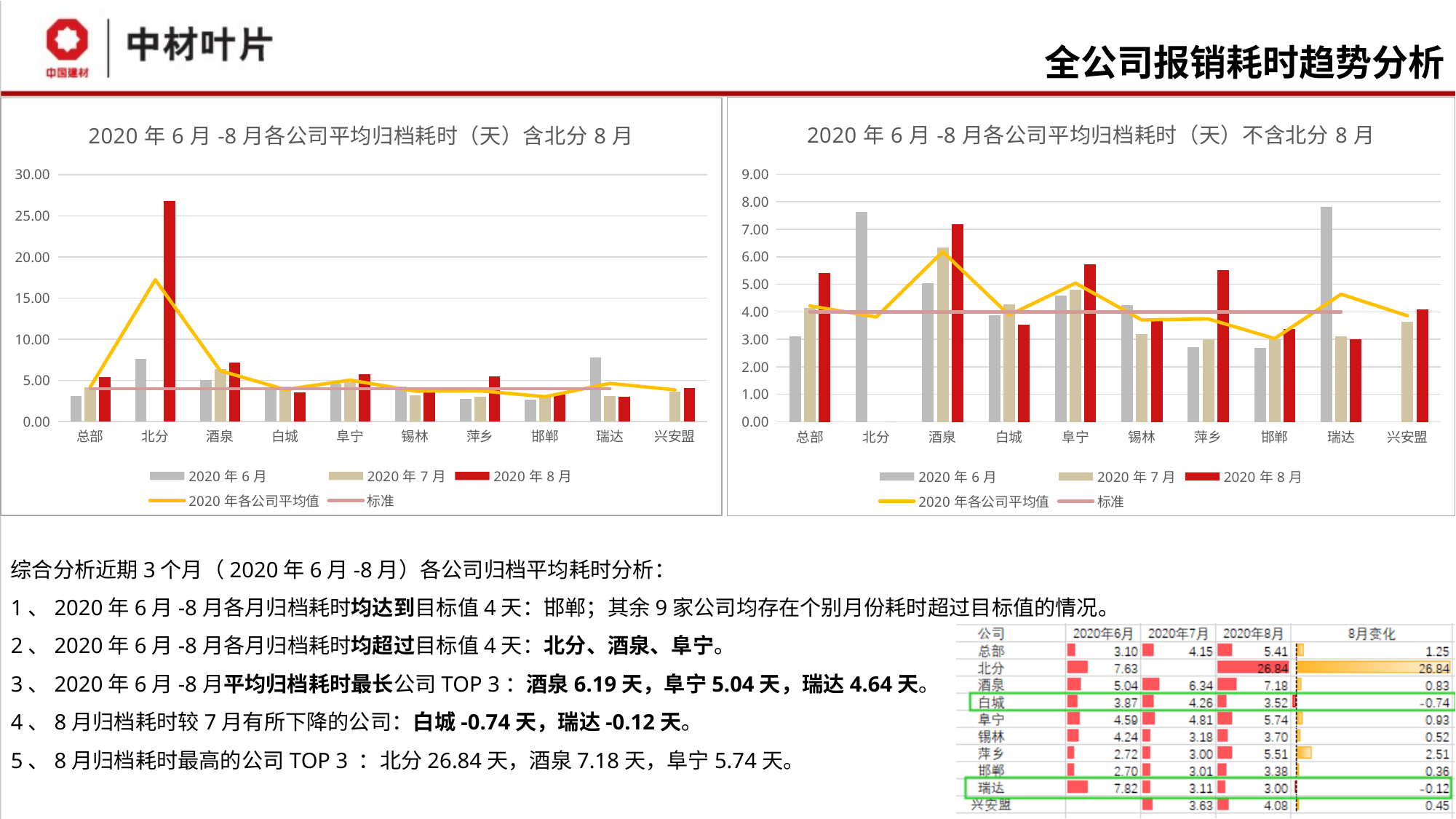
In the left chart (含北分8月), which company has the tallest 2020年8月 bar? 北分 How many series does the legend of the left chart (含北分8月) list? 5 In the right chart (不含北分8月), which company has the tallest 2020年8月 bar? 酒泉 According to the slide, what is the 2020年7月 value for 酒泉? 6.34 How many companies are shown on the x axis of the right chart (不含北分8月)? 10 According to the slide, what is the 2020年8月 value for 北分? 26.84 In the right chart (不含北分8月), which is larger, the 2020年8月 value for 阜宁 or for 锡林? 阜宁 In the right chart (不含北分8月), is the 2020年6月 value for 瑞达 greater or less than 7.00? greater What kind of chart is the left chart titled 2020年6月-8月各公司平均归档耗时（天）含北分8月? bar chart with lines In the left chart (含北分8月), is the 2020年8月 value for 北分 greater or less than 25.00? greater At what value does the 标准 line sit in the right chart (不含北分8月)? 4.00 In the right chart (不含北分8月), is the 2020年6月 value for 总部 greater or less than 4.00? less